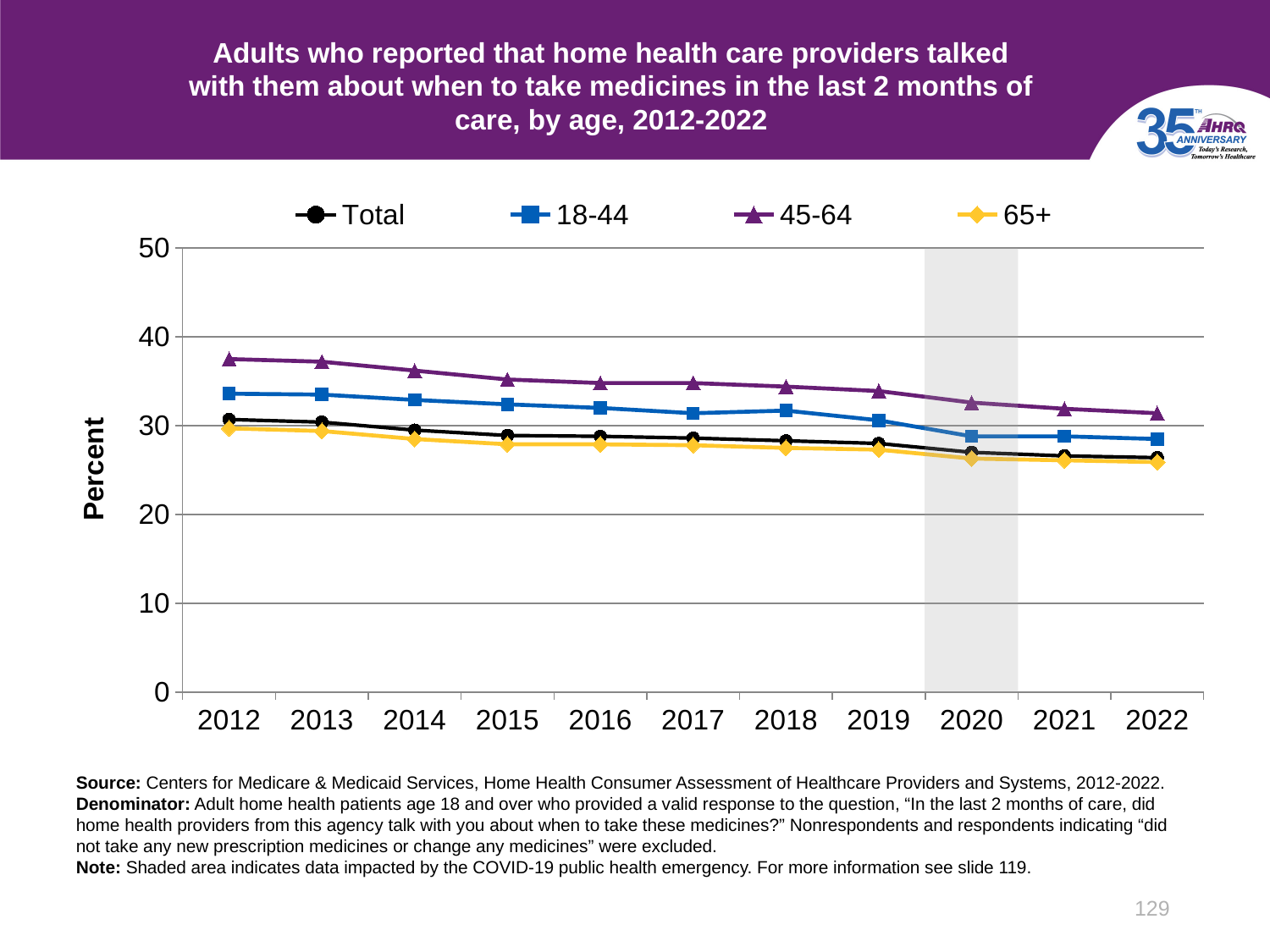
Is the value for the 65+ group in 2022 greater or less than 30? less How many series does the legend list? 4 Which age group has the highest value in 2015? 45-64 What is the label on the y axis? Percent What kind of chart is shown on the slide? Line chart According to the note, what does the shaded area on the chart indicate? Data impacted by the COVID-19 public health emergency Does the value for the 45-64 group rise or fall from 2012 to 2022? Fall Which is larger in 2018, the value for 18-44 or the value for Total? 18-44 How many years are plotted along the x axis? 11 Which age group has the lowest value in 2012? 65+ Is the value for the 45-64 group in 2012 greater or less than 30? greater Is the value for the 45-64 group in 2022 greater or less than 40? less